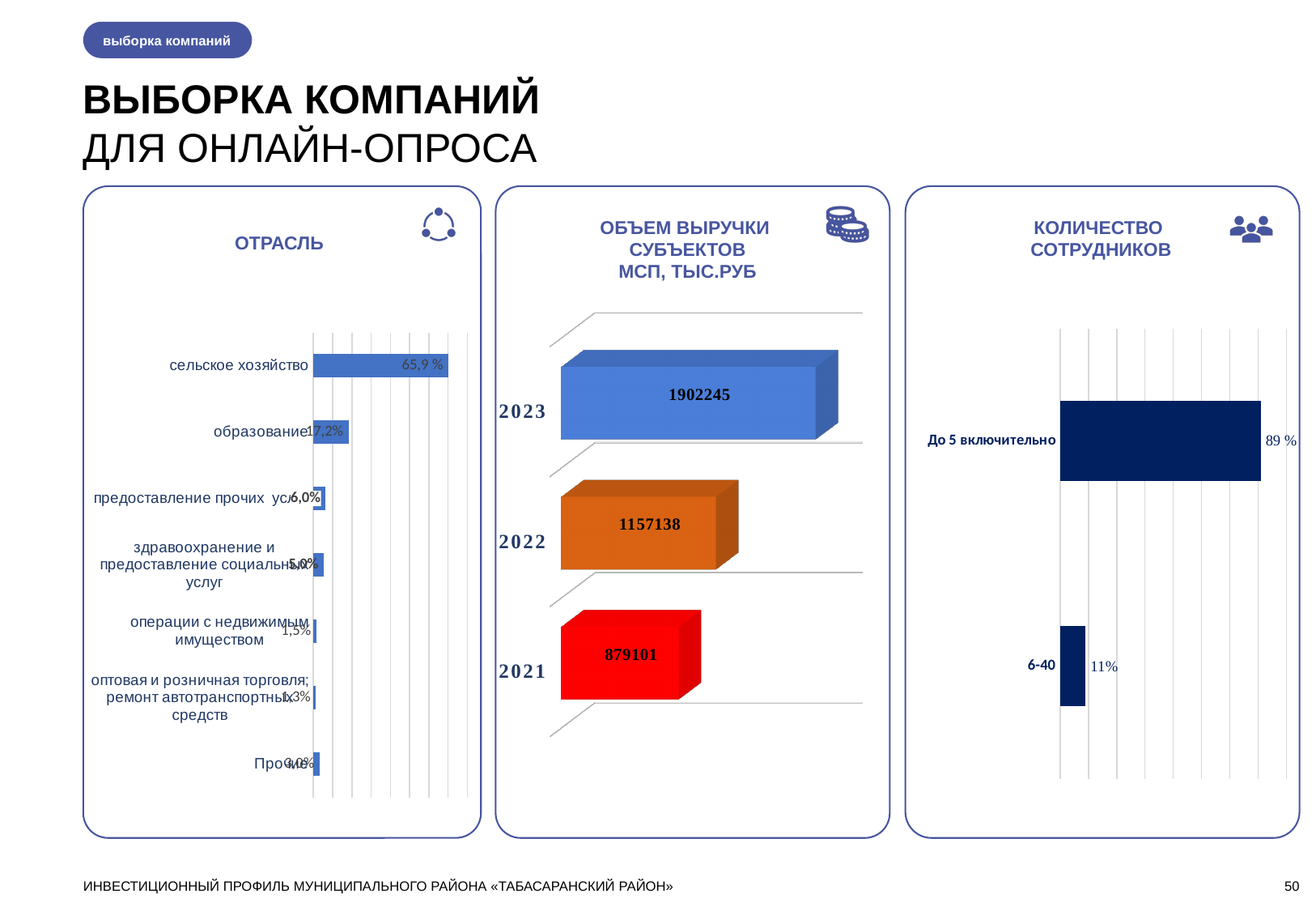
In the 'ОБЪЕМ ВЫРУЧКИ СУБЪЕКТОВ МСП, ТЫС.РУБ' chart, what is the value for 2021? 879101 How many categories are shown in the 'ОТРАСЛЬ' chart? 7 In the 'ОТРАСЛЬ' chart, what is the value for сельское хозяйство? 65,9 % In the 'КОЛИЧЕСТВО СОТРУДНИКОВ' chart, which is larger: 'До 5 включительно' or '6-40'? До 5 включительно In the 'КОЛИЧЕСТВО СОТРУДНИКОВ' chart, what is the value for 'До 5 включительно'? 89 % In the 'ОБЪЕМ ВЫРУЧКИ СУБЪЕКТОВ МСП, ТЫС.РУБ' chart, what is the difference between the 2023 and 2022 values? 745107 In the 'ОБЪЕМ ВЫРУЧКИ СУБЪЕКТОВ МСП, ТЫС.РУБ' chart, which year has the lowest value? 2021 In the 'ОБЪЕМ ВЫРУЧКИ СУБЪЕКТОВ МСП, ТЫС.РУБ' chart, what is the value for 2023? 1902245 What kind of chart is the 'ОТРАСЛЬ' chart? bar chart In the 'ОТРАСЛЬ' chart, what is the value for образование? 17,2% In the 'ОБЪЕМ ВЫРУЧКИ СУБЪЕКТОВ МСП, ТЫС.РУБ' chart, do the values rise or fall from 2021 to 2023? rise In the 'ОТРАСЛЬ' chart, which category has the highest value? сельское хозяйство